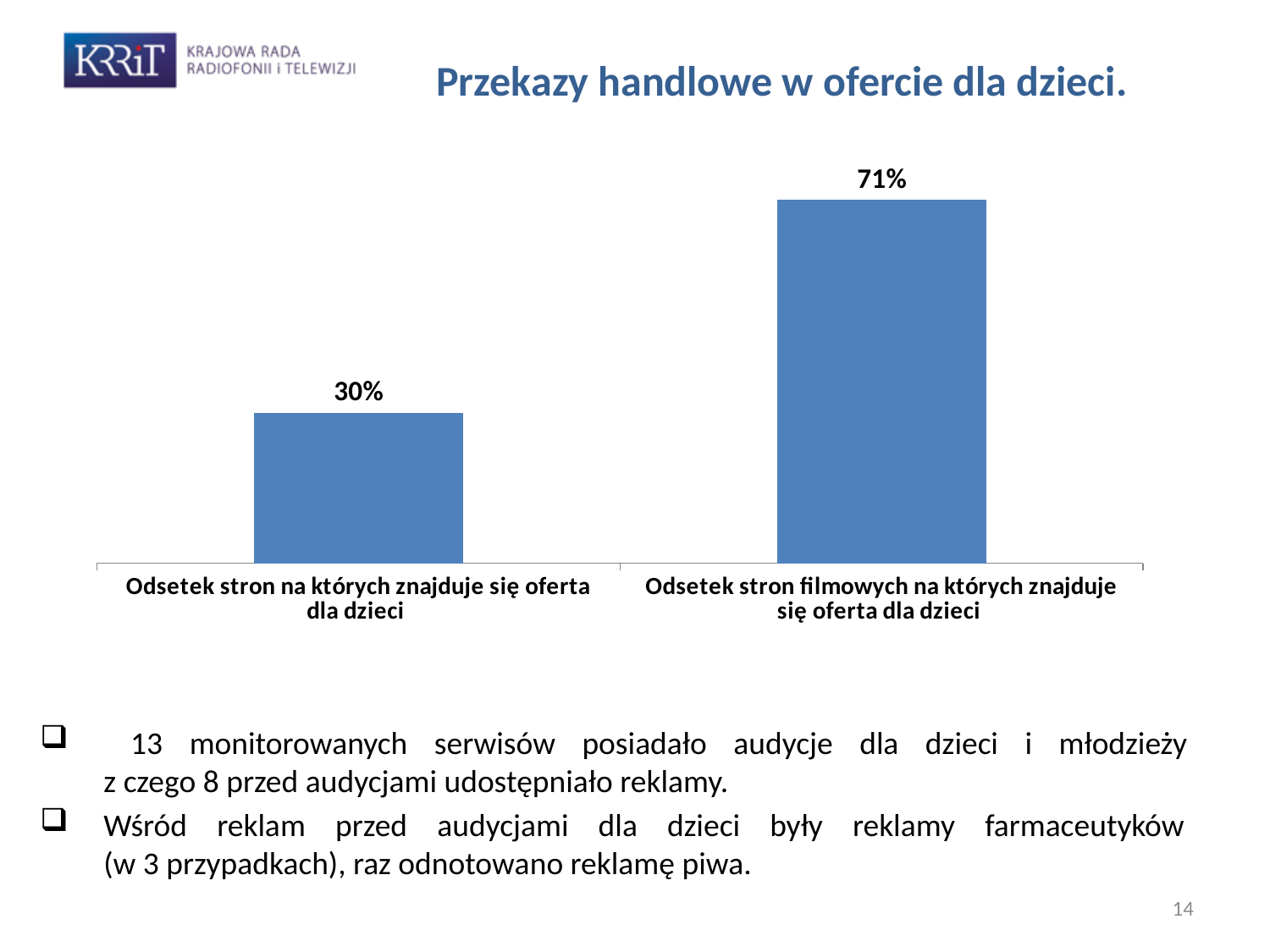
What kind of chart is shown on the slide? Bar chart How many categories are shown in the chart? 2 What colour are the bars in the chart? Blue What is the title of the slide containing the chart? Przekazy handlowe w ofercie dla dzieci. What is the difference between the value for "Odsetek stron filmowych na których znajduje się oferta dla dzieci" and the value for "Odsetek stron na których znajduje się oferta dla dzieci"? 41% Which category has the lowest value? Odsetek stron na których znajduje się oferta dla dzieci What is the value for "Odsetek stron na których znajduje się oferta dla dzieci"? 30% What is the value for "Odsetek stron filmowych na których znajduje się oferta dla dzieci"? 71% Which category has the highest value? Odsetek stron filmowych na których znajduje się oferta dla dzieci Which is larger: the value for "Odsetek stron na których znajduje się oferta dla dzieci" or the value for "Odsetek stron filmowych na których znajduje się oferta dla dzieci"? Odsetek stron filmowych na których znajduje się oferta dla dzieci Do the values rise or fall from left to right across the categories? Rise